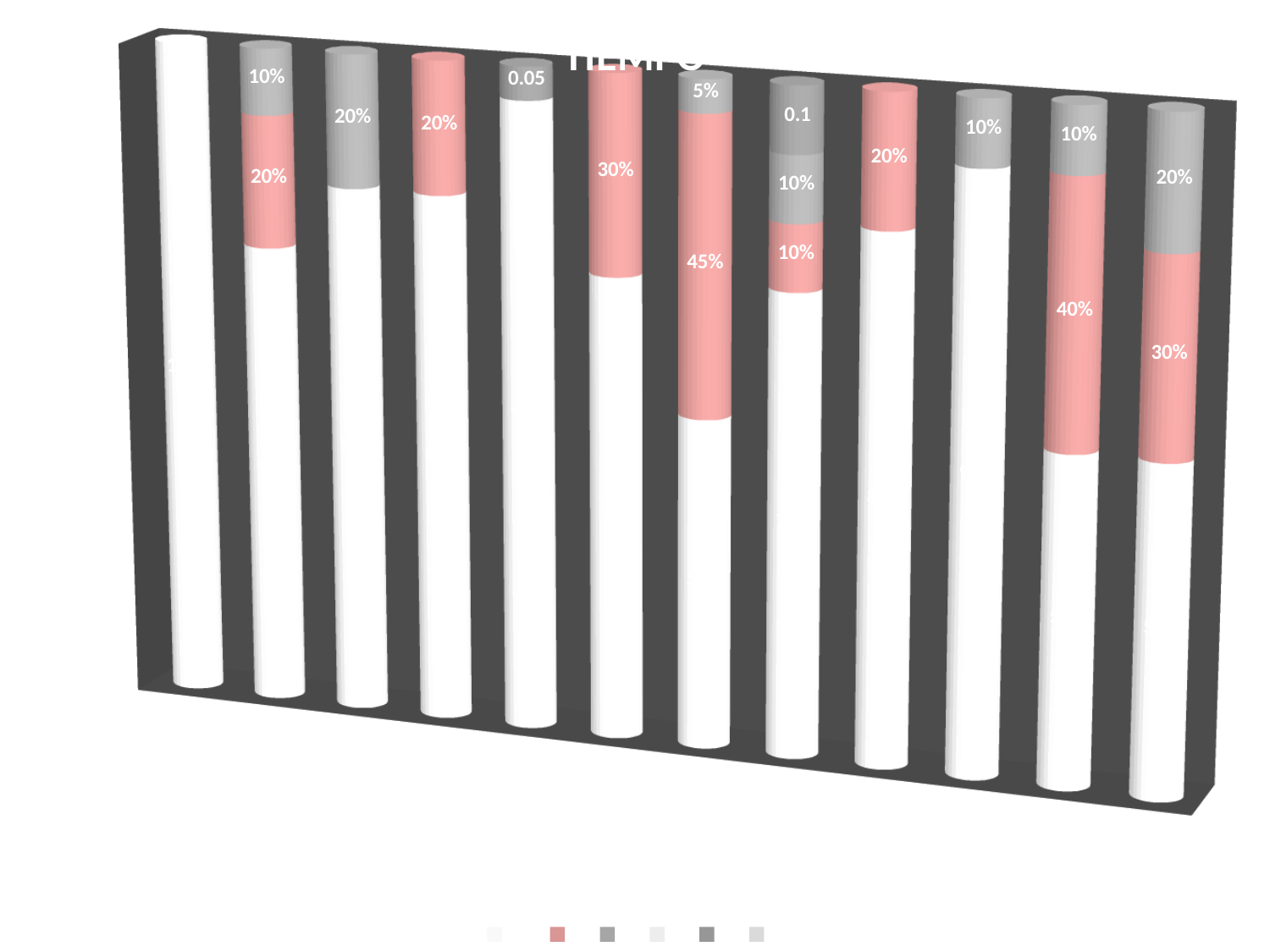
What value is printed on the grey segment at the top of the fifth bar from the left? 0.05 What colour is the segment labelled 45% in the seventh bar from the left? pink How many bars are plotted in the chart? 12 What kind of chart is shown on the slide? bar chart What value is printed on the pink segment of the seventh bar from the left? 45% What value is printed on the grey segment of the second bar from the left? 10% What value is printed on the pink segment of the eleventh bar from the left? 40% What value is printed on the pink segment of the rightmost bar? 30% Which is larger: the pink segment of the seventh bar from the left (45%) or the pink segment of the sixth bar from the left (30%)? the seventh bar (45%) How many series does the legend list? 6 What is the difference between the pink segment of the eleventh bar from the left (40%) and the pink segment of the rightmost bar (30%)? 10% What value is printed on the pink segment of the second bar from the left? 20%